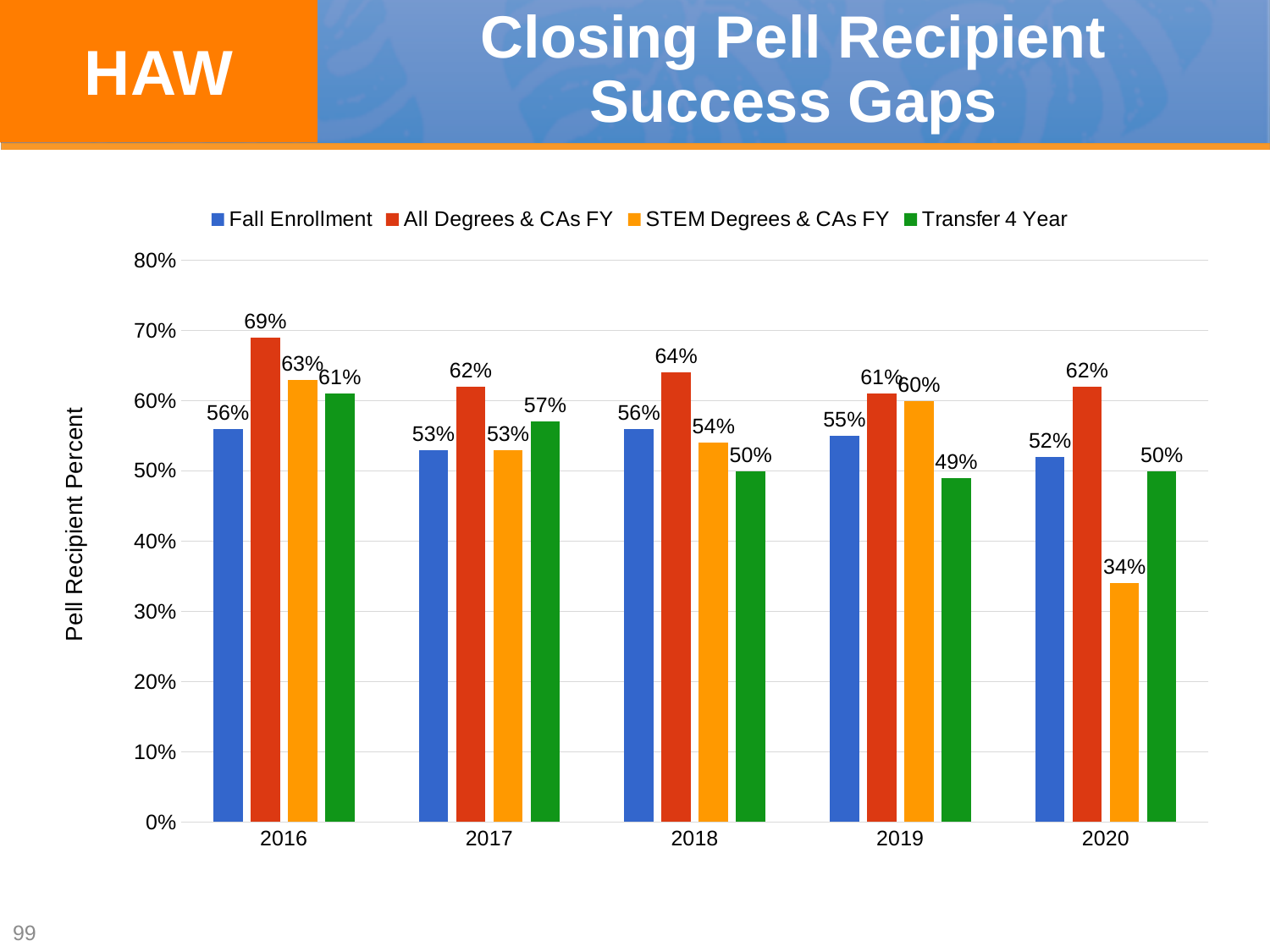
How many years are shown on the x axis? 5 What is the value for STEM Degrees & CAs FY in 2020? 34% What is the value for Transfer 4 Year in 2019? 49% How many series does the legend list? 4 What is the label of the vertical axis? Pell Recipient Percent In which year is the STEM Degrees & CAs FY value lowest? 2020 What is the difference between All Degrees & CAs FY and Fall Enrollment in 2020? 10% Which is larger in 2017: STEM Degrees & CAs FY or Transfer 4 Year? Transfer 4 Year In which year is the All Degrees & CAs FY value highest? 2016 What kind of chart is shown on the slide? Bar chart What is the value for All Degrees & CAs FY in 2016? 69% What is the value for Fall Enrollment in 2018? 56%